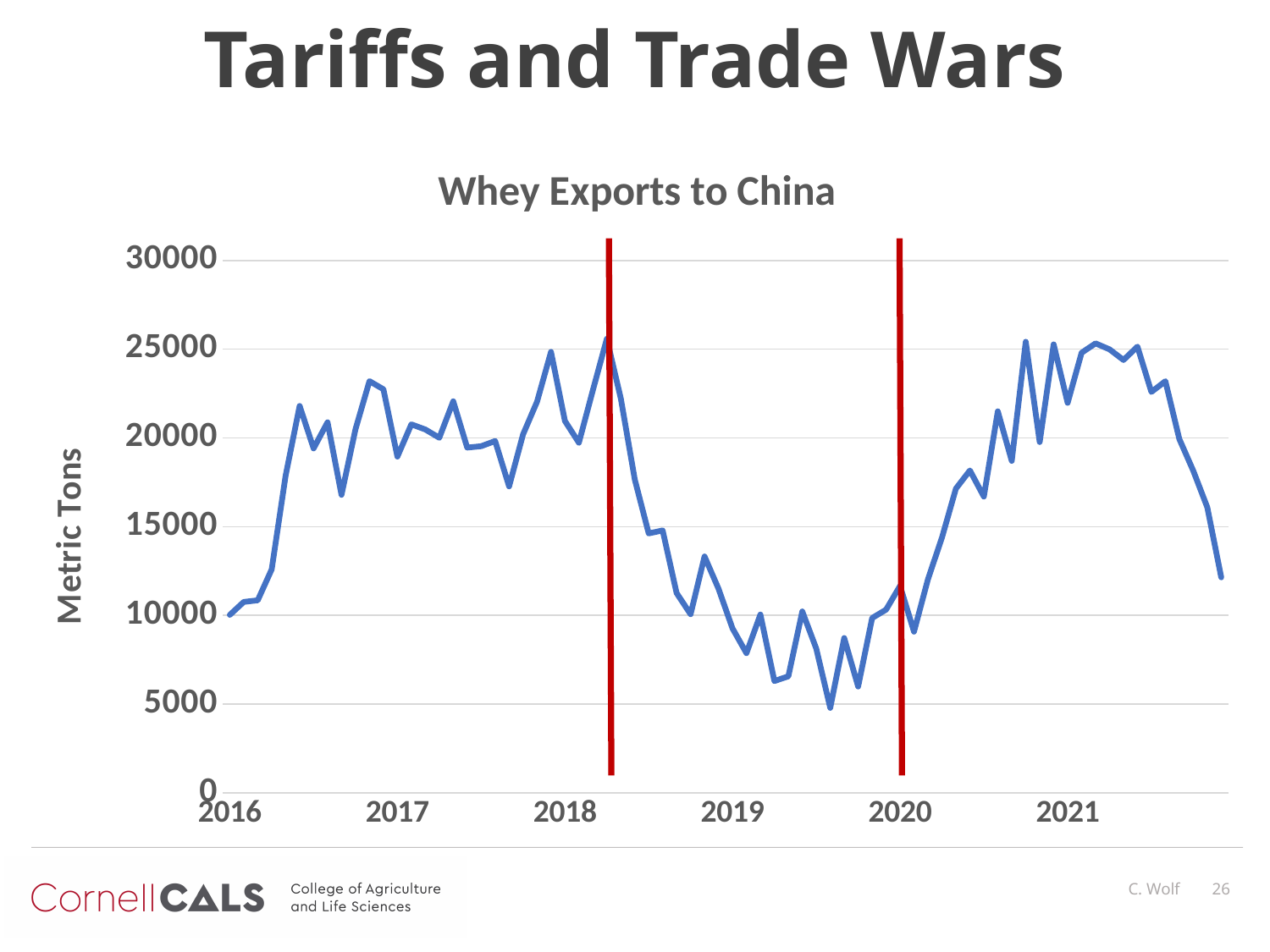
Do whey exports to China rise or fall between the start of 2020 and the start of 2021? rise What is the label on the y axis of the chart? Metric Tons Is the value of whey exports at the end of 2021 greater or less than 15000? less Is the value of whey exports at the start of 2016 greater or less than 15000? less Is the value of whey exports at the start of 2020 greater or less than 15000? less Which year contains the lowest point on the line, 2019 or 2021? 2019 What kind of chart is shown on the slide? line chart What is the highest value shown on the y axis? 30000 Do whey exports to China rise or fall between the 2018 peak and mid-2019? fall What is the title of the chart? Whey Exports to China